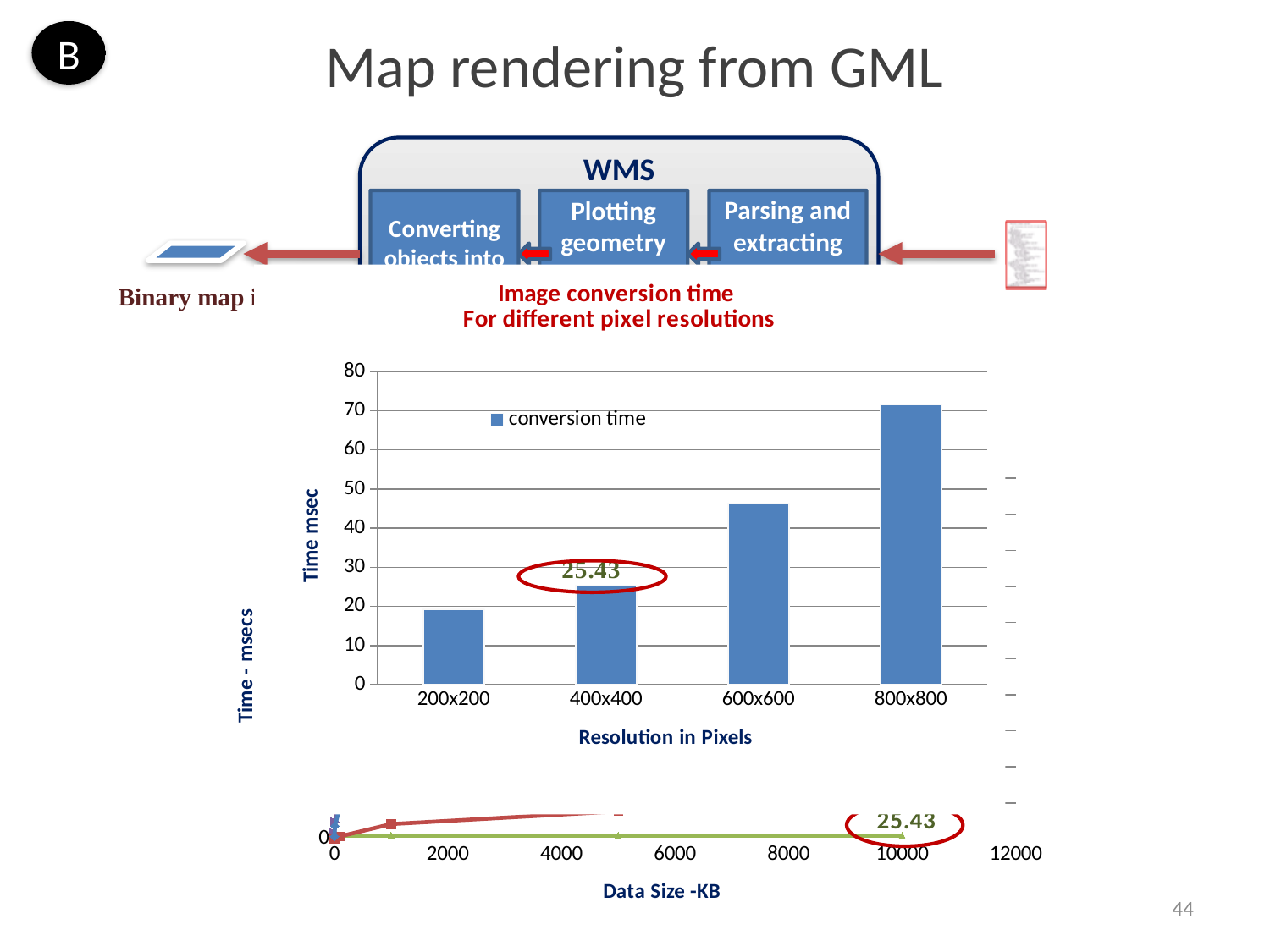
In the 'Image conversion time For different pixel resolutions' chart, what is the name of the series shown in the legend? conversion time In the 'Image conversion time For different pixel resolutions' chart, what is the conversion time for the 400x400 resolution? 25.43 In the 'Image conversion time For different pixel resolutions' chart, is the conversion time for 800x800 greater or less than 60? greater In the 'Image conversion time For different pixel resolutions' chart, how many series does the legend list? 1 In the 'Image conversion time For different pixel resolutions' chart, what is the title of the vertical axis? Time msec In the 'Image conversion time For different pixel resolutions' chart, which has the larger conversion time, 600x600 or 400x400? 600x600 In the 'Image conversion time For different pixel resolutions' chart, which resolution has the lowest conversion time? 200x200 In the 'Image conversion time For different pixel resolutions' chart, how many resolution categories are shown on the x axis? 4 In the 'Image conversion time For different pixel resolutions' chart, which resolution has the highest conversion time? 800x800 In the 'Image conversion time For different pixel resolutions' chart, what kind of chart is used to show the conversion times? bar chart In the 'Image conversion time For different pixel resolutions' chart, is the conversion time for 200x200 greater or less than 30? less In the 'Image conversion time For different pixel resolutions' chart, does the conversion time rise or fall as the resolution increases from 200x200 to 800x800? rise